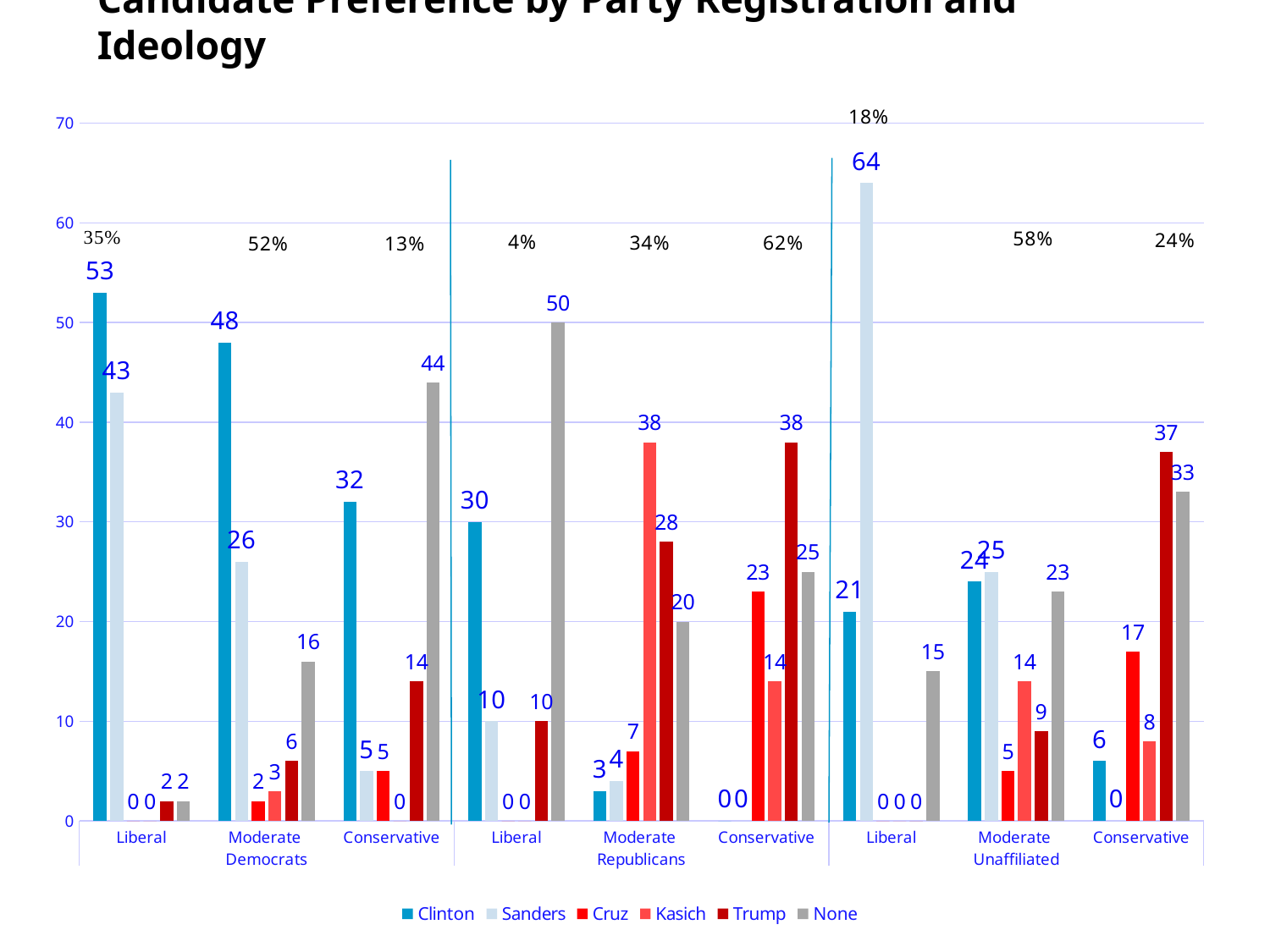
What is the value for Kasich among Moderate Republicans? 38 What is the difference between Clinton and Sanders among Moderate Democrats? 22 How many series does the legend list? 6 Which candidate has the highest value among Conservative Republicans? Trump What is the value for Sanders among Liberal Unaffiliated voters? 64 Which series has the highest value among Liberal Republicans? None Which is larger among Conservative Unaffiliated voters: Trump or None? Trump What percentage label is shown above the Conservative Republicans group? 62% What is the value for Cruz among Conservative Republicans? 23 What is the value for Clinton among Liberal Democrats? 53 What is the value for None among Conservative Democrats? 44 What kind of chart is shown on the slide? bar chart